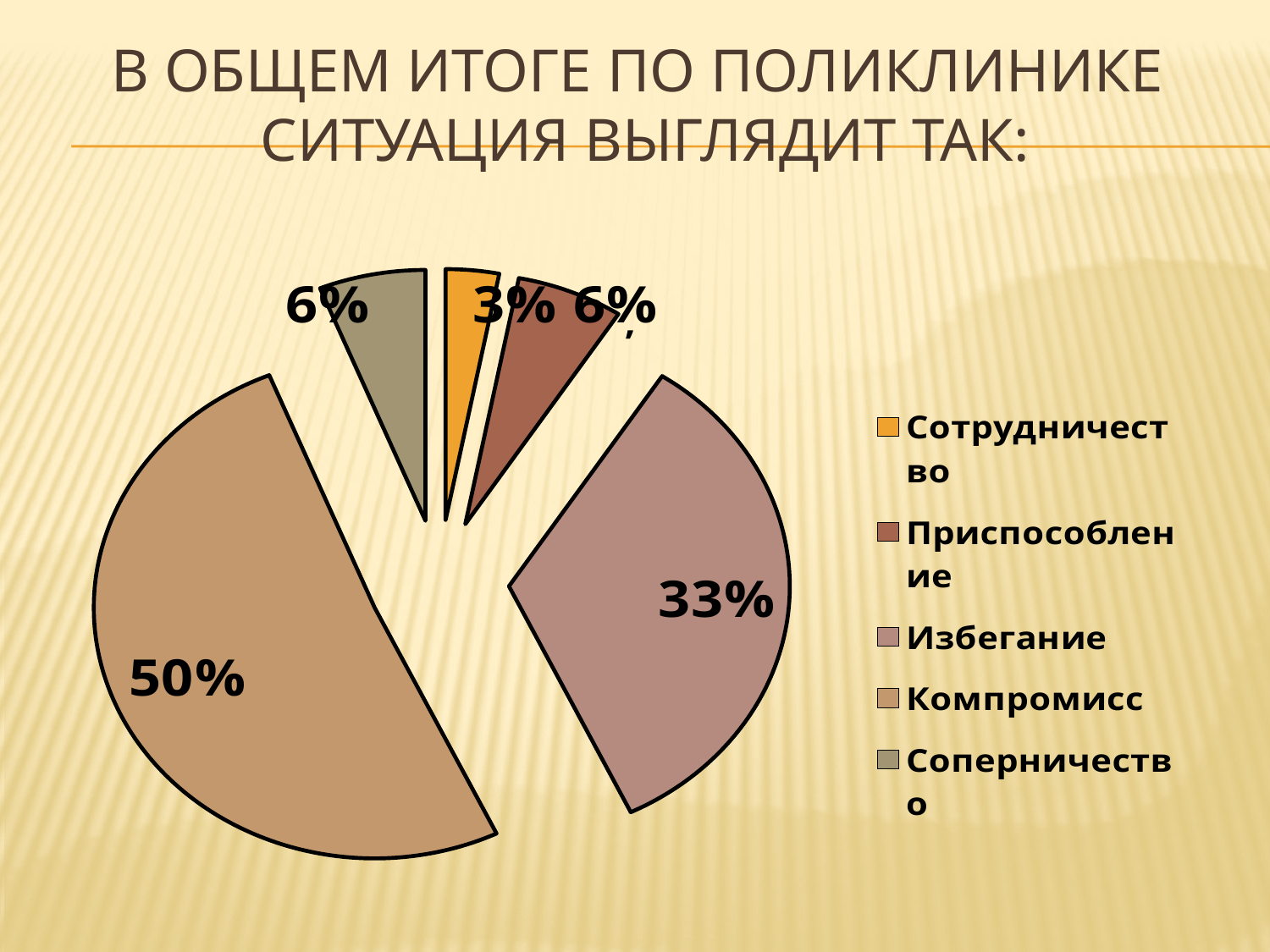
Which is larger, the share for Избегание or the share for Приспособление? Избегание How many entries does the legend list? 5 How many slices does the pie chart have? 5 What percentage is shown for Соперничество? 6% What percentage does the Компромисс slice represent in the pie chart? 50% What percentage is shown for Приспособление? 6% Which category has the smallest share of the pie? Сотрудничество What kind of chart is shown on the slide? Pie chart What percentage does the Избегание slice represent? 33% What is the difference in percentage points between Компромисс and Избегание? 17 Which category has the largest share of the pie? Компромисс What percentage is shown for Сотрудничество? 3%